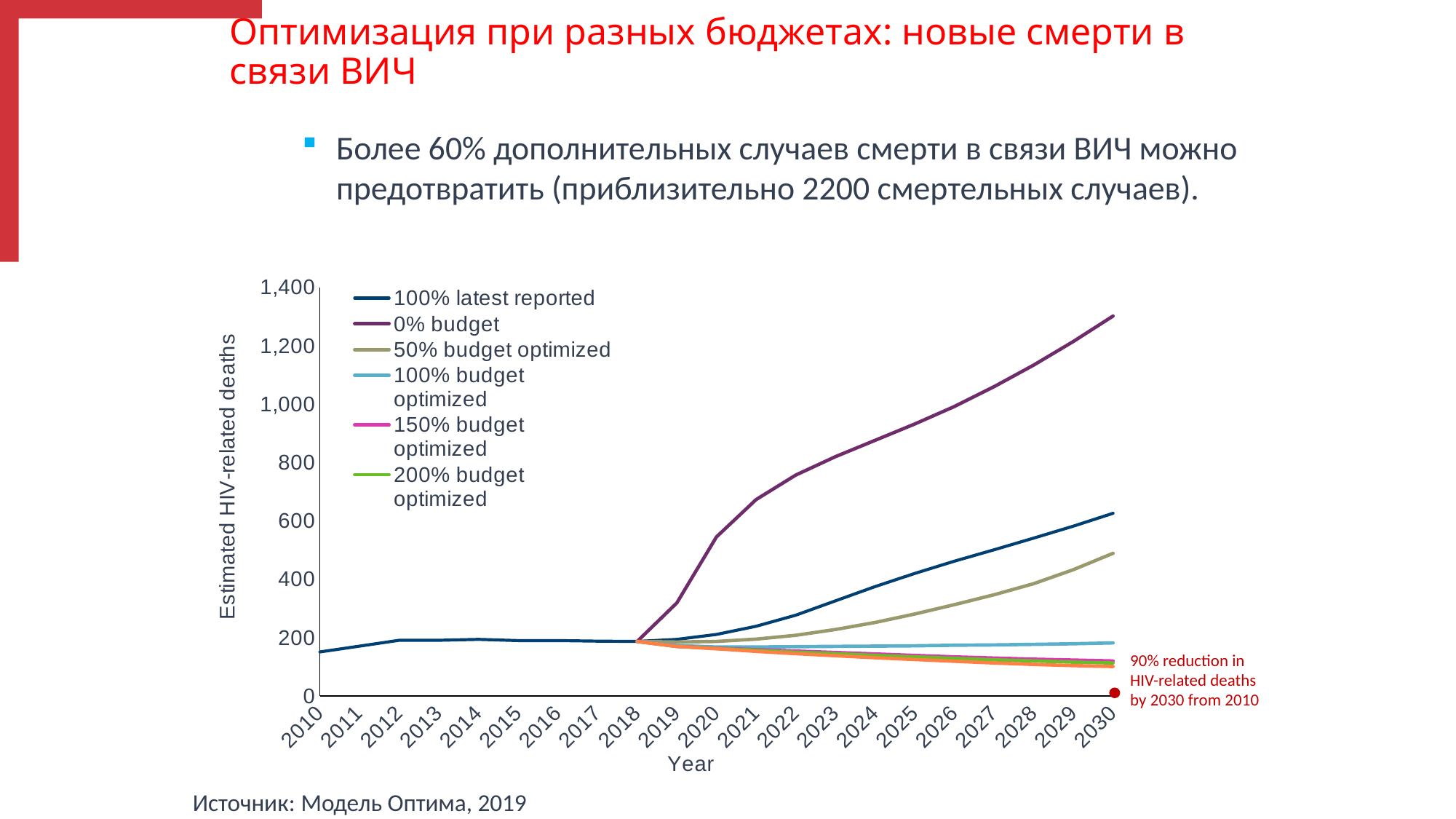
Is the value for the 100% latest reported series in 2030 greater or less than 800? less Is the value for the 50% budget optimized series in 2030 greater or less than 400? greater Is the value for the 100% budget optimized series in 2030 greater or less than 400? less Does the 0% budget series rise or fall between 2018 and 2030? Rise How many series does the chart legend list? 6 Which series has the highest value in 2030? 0% budget What kind of chart is shown on the slide? Line chart In 2030, which is larger: the 0% budget series or the 100% latest reported series? 0% budget How many years are labelled along the x axis of the chart? 21 What is the title of the chart's y axis? Estimated HIV-related deaths What does the red dot annotation at the right of the chart say? 90% reduction in HIV-related deaths by 2030 from 2010